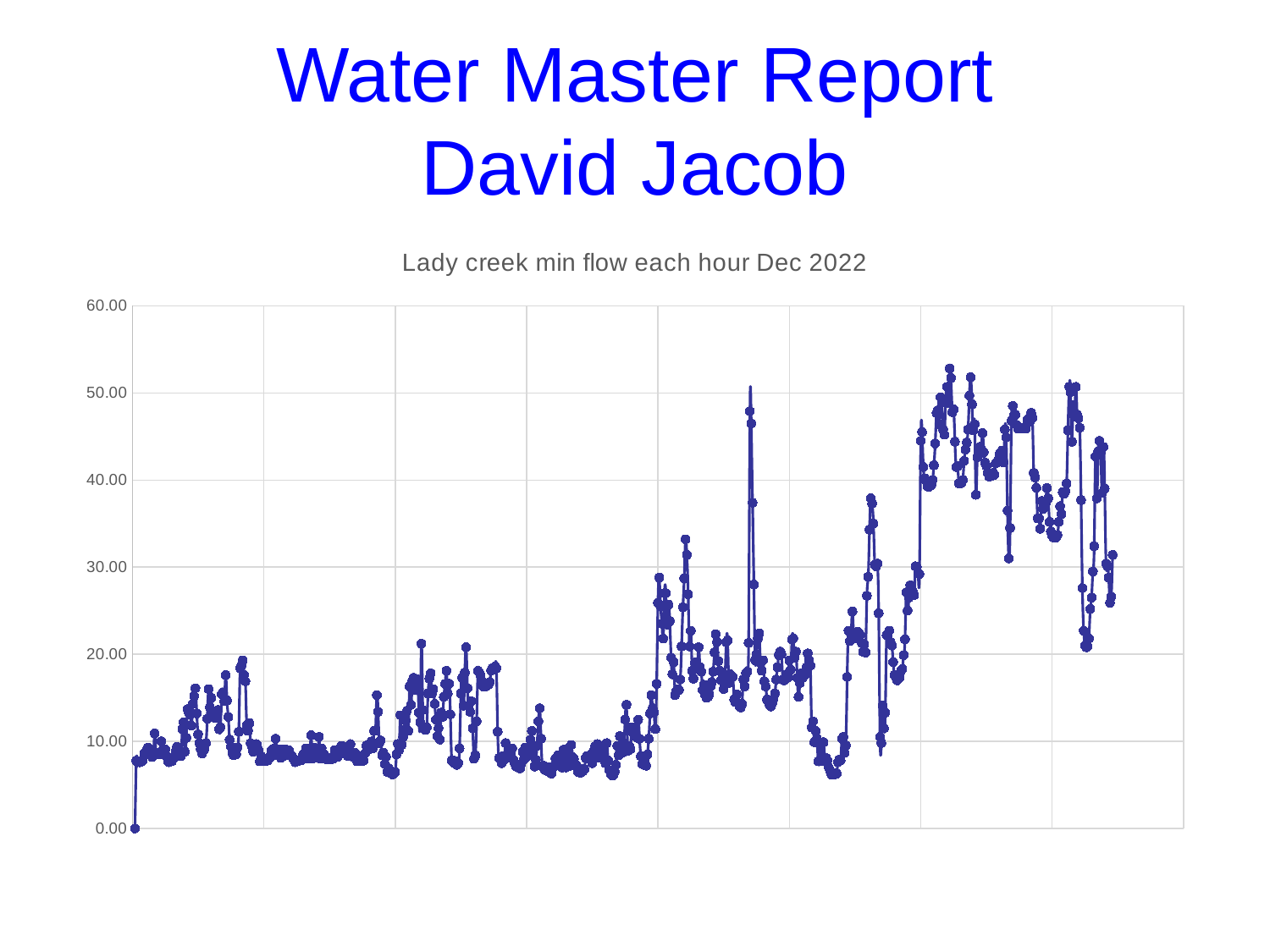
What is the value of the first plotted point at the far left of the chart? 0.00 Is the value of the last plotted point at the far right of the chart greater or less than 40? less Which half of the chart contains the highest plotted value, the left half or the right half? the right half Is the value of the last plotted point at the far right of the chart greater or less than 20? greater What kind of chart is shown on the slide? line chart What is the title of the chart? Lady creek min flow each hour Dec 2022 What is the highest tick value shown on the y axis? 60.00 Which is higher: the value at the far right end of the chart or the value at the far left end? the far right end Overall, do the plotted values rise or fall from left to right across the chart? rise Is the highest value plotted on the chart greater or less than 60? less